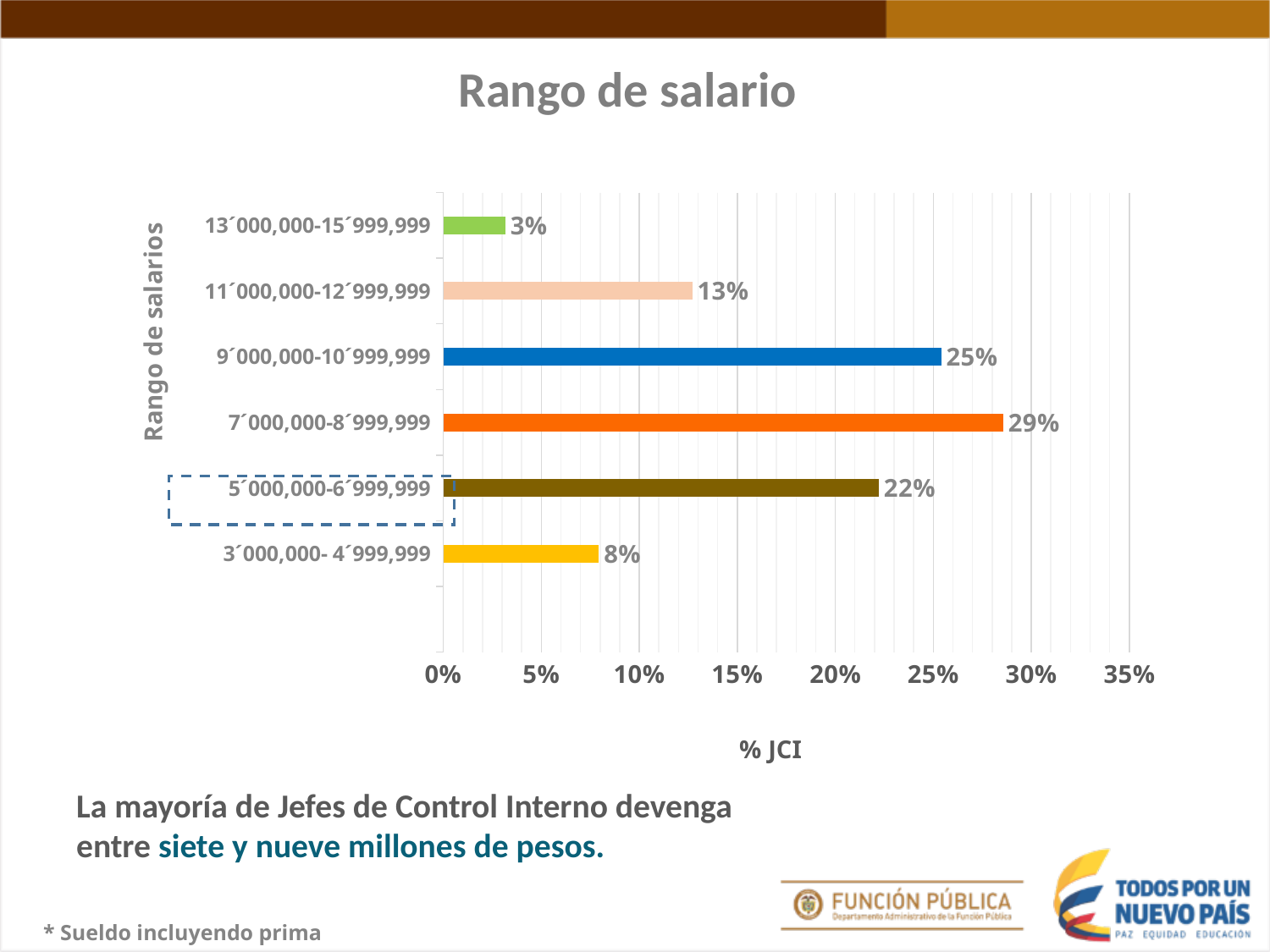
How many salary ranges are plotted in the chart? 6 What is the value shown for the 13´000,000-15´999,999 salary range? 3% What percentage is shown for the 5´000,000-6´999,999 salary range? 22% What is the difference between the percentages for the 9´000,000-10´999,999 and 11´000,000-12´999,999 ranges? 12% What is the combined percentage for the 7´000,000-8´999,999 and 9´000,000-10´999,999 ranges? 54% What is the label of the horizontal axis? % JCI What percentage of JCI earn a salary in the 7´000,000-8´999,999 range? 29% Which salary range has the highest percentage of JCI? 7´000,000-8´999,999 Which has a larger percentage: the 3´000,000- 4´999,999 range or the 11´000,000-12´999,999 range? 11´000,000-12´999,999 What is the title of the chart? Rango de salario Which salary range has the lowest percentage of JCI? 13´000,000-15´999,999 What type of chart is shown on the slide? Bar chart